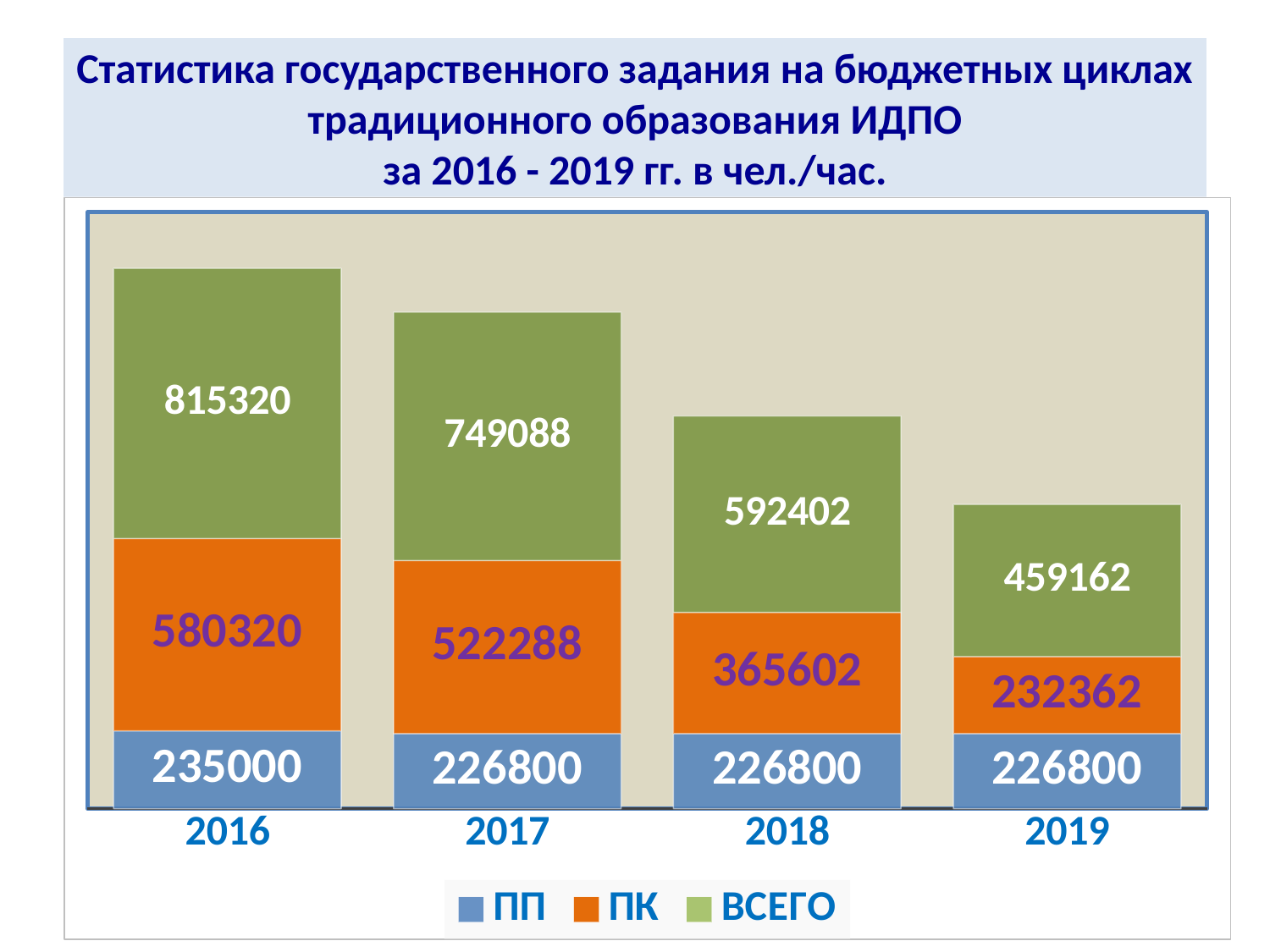
How many years are shown on the x axis? 4 How many series does the legend list? 3 What is the value of ПК for 2019? 232362 What is the difference between the ПК values for 2017 and 2018? 156686 Which is larger: ПК for 2016 or ВСЕГО for 2019? ПК for 2016 Which year has the lowest ПК value? 2019 What is the value of ПП for 2016? 235000 Do the ВСЕГО values rise or fall from 2016 to 2019? fall What kind of chart is shown on the slide? stacked bar chart What is the value of ПК for 2018? 365602 What is the value of ВСЕГО for 2016? 815320 Which year has the highest ВСЕГО value? 2016